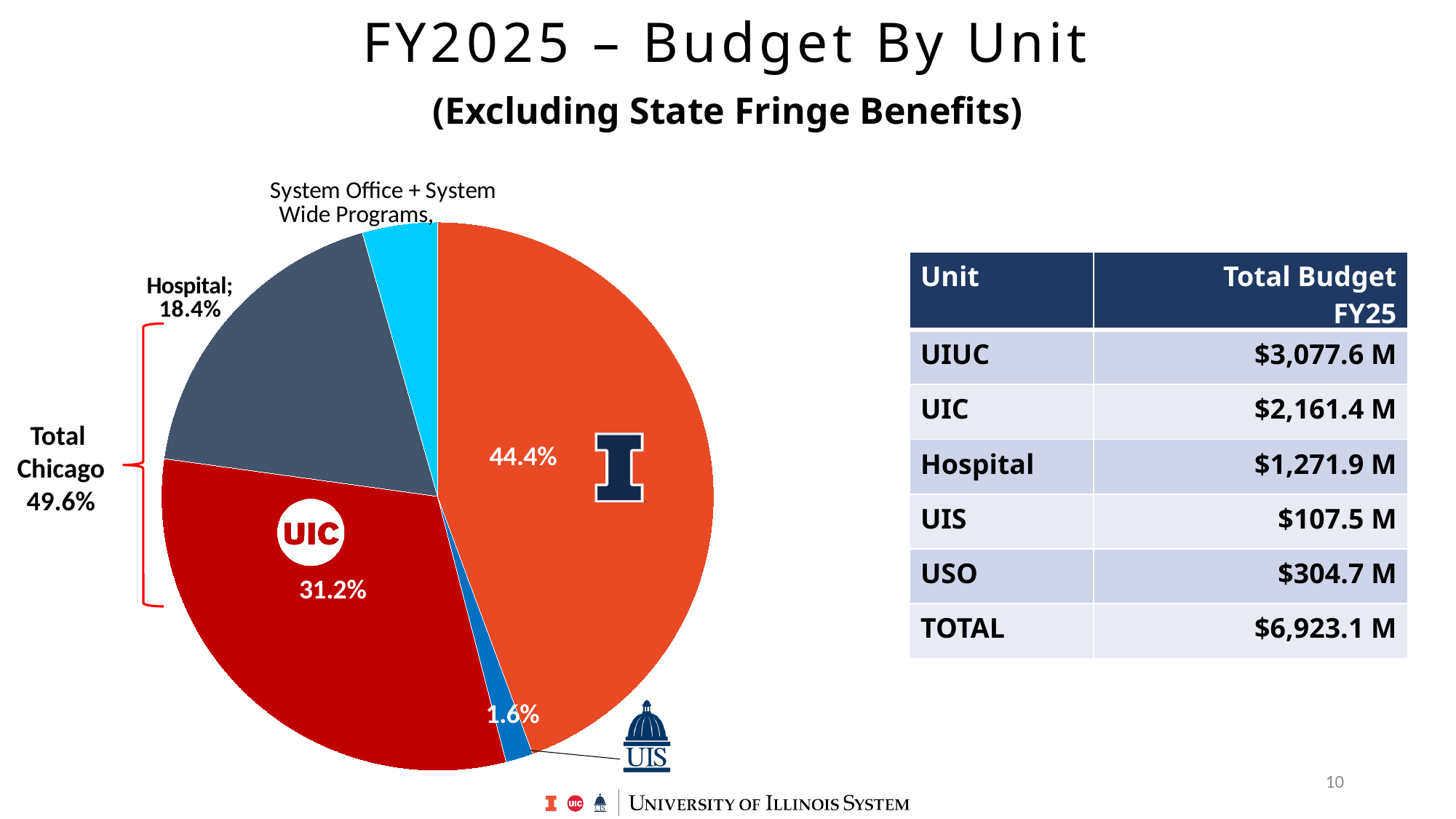
What percentage is shown for the slice marked with the UIS logo? 1.6% Which slice of the pie chart is the largest? The orange UIUC slice (44.4%) What kind of chart is shown on the slide? Pie chart Which slice of the pie chart is the smallest? The UIS slice (1.6%) What percentage is shown on the red slice marked with the UIC logo? 31.2% What percentage is shown for the Hospital slice of the pie chart? 18.4% How many slices does the pie chart have? 5 What is the title of the slide containing the pie chart? FY2025 – Budget By Unit (Excluding State Fringe Benefits) What combined percentage does the bracket labelled 'Total Chicago' show for the UIC and Hospital slices? 49.6% What percentage is shown on the orange slice marked with the block I (UIUC) logo? 44.4% Which is larger in the pie chart, the UIC slice or the Hospital slice? The UIC slice What is the difference in percentage points between the UIUC slice (44.4%) and the UIC slice (31.2%)? 13.2 percentage points